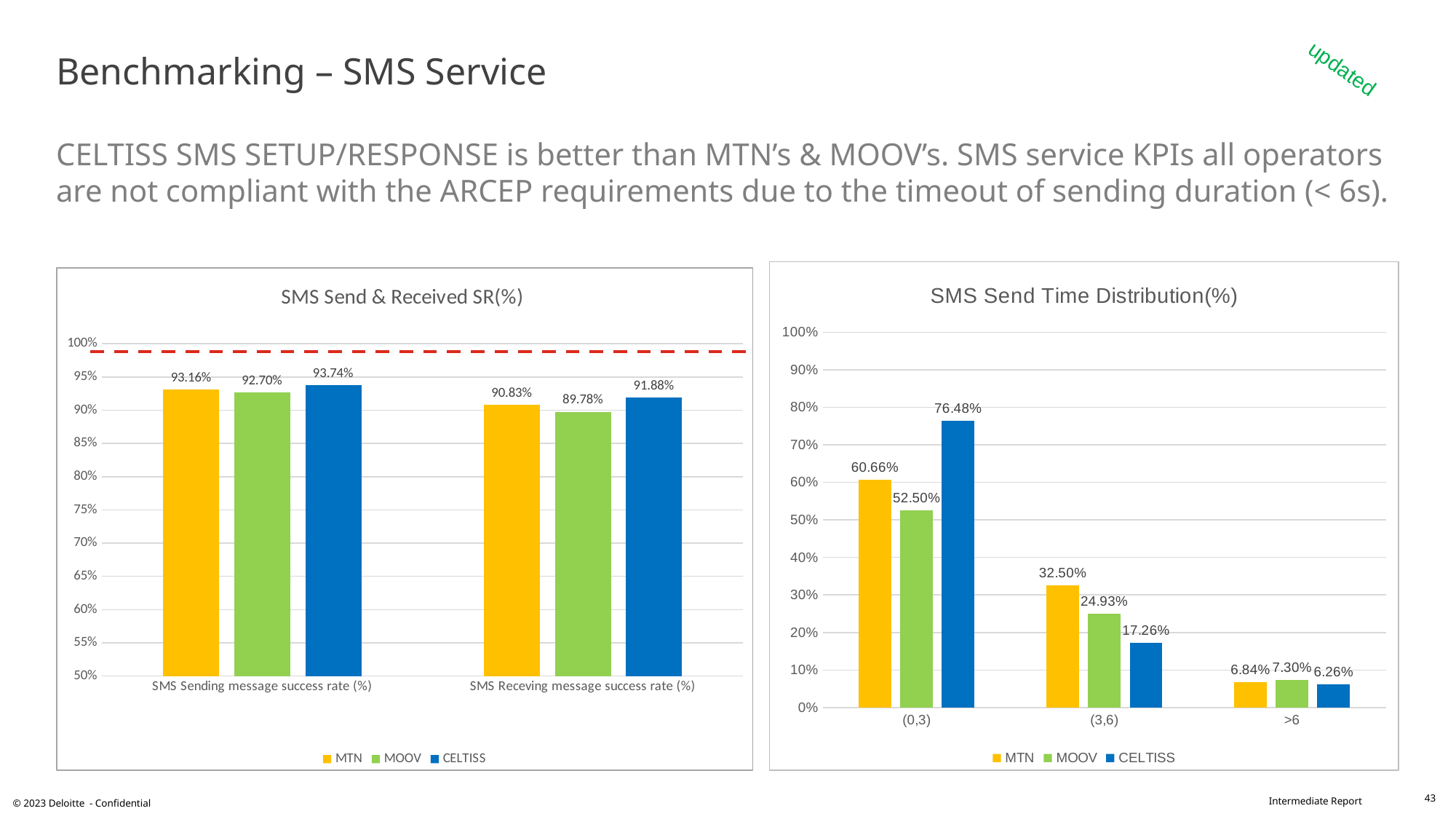
In the 'SMS Send Time Distribution(%)' chart, what is the difference between MTN and MOOV in the (0,3) category? 8.16% In the 'SMS Send Time Distribution(%)' chart, what is the value for CELTISS in the (0,3) category? 76.48% In the 'SMS Send & Received SR(%)' chart, which operator has the highest SMS Receving message success rate (%)? CELTISS In the 'SMS Send Time Distribution(%)' chart, is the value for MTN in the (3,6) category greater or less than 30%? greater What kind of chart is the 'SMS Send Time Distribution(%)' chart? Bar chart In the 'SMS Send & Received SR(%)' chart, what is the value for MOOV for SMS Receving message success rate (%)? 89.78% In the 'SMS Send Time Distribution(%)' chart, what is the value for MOOV in the (3,6) category? 24.93% In the 'SMS Send & Received SR(%)' chart, what is the value for CELTISS for SMS Sending message success rate (%)? 93.74% In the 'SMS Send & Received SR(%)' chart, what is the difference between CELTISS and MTN for SMS Sending message success rate (%)? 0.58% In the 'SMS Send Time Distribution(%)' chart, which operator has the lowest value in the >6 category? CELTISS In the 'SMS Send & Received SR(%)' chart, how many series does the legend list? 3 In the 'SMS Send Time Distribution(%)' chart, how many categories are shown on the x axis? 3